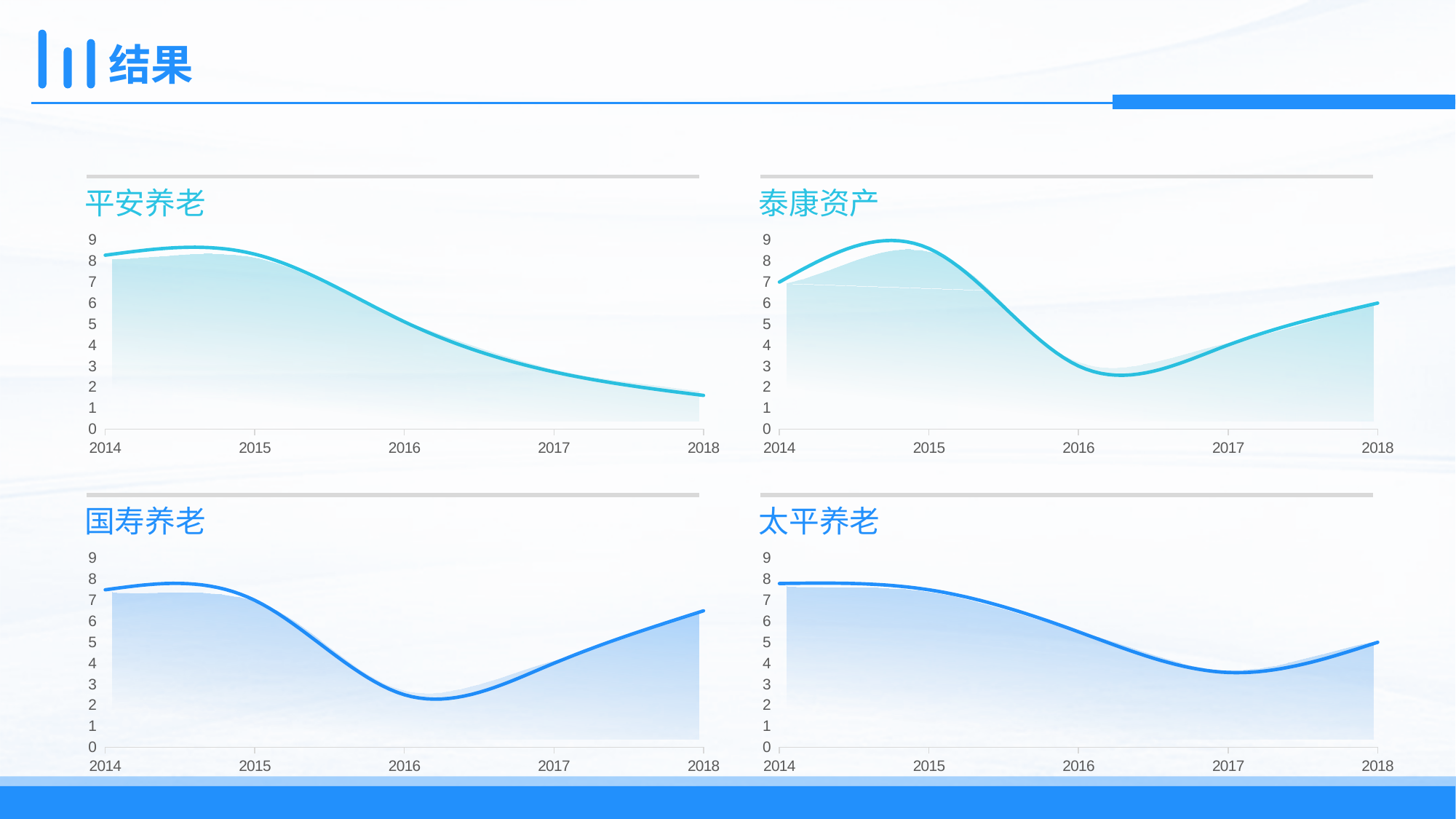
In the 太平养老 chart, which year has the lowest value? 2017 In the 平安养老 chart, do the values rise or fall from 2014 to 2018? fall In the 泰康资产 chart, which year has the highest value? 2015 In the 国寿养老 chart, which year has the lowest value? 2016 In the 平安养老 chart, is the value for 2014 greater or less than 7? greater How many years are plotted on the x axis of the 泰康资产 chart? 5 In the 国寿养老 chart, is the value for 2018 greater or less than 5? greater What kind of chart is used for 平安养老? line chart In the 太平养老 chart, which is larger, the value for 2014 or the value for 2018? 2014 How many charts are shown on the slide? 4 In the 平安养老 chart, is the value for 2018 greater or less than 2? less